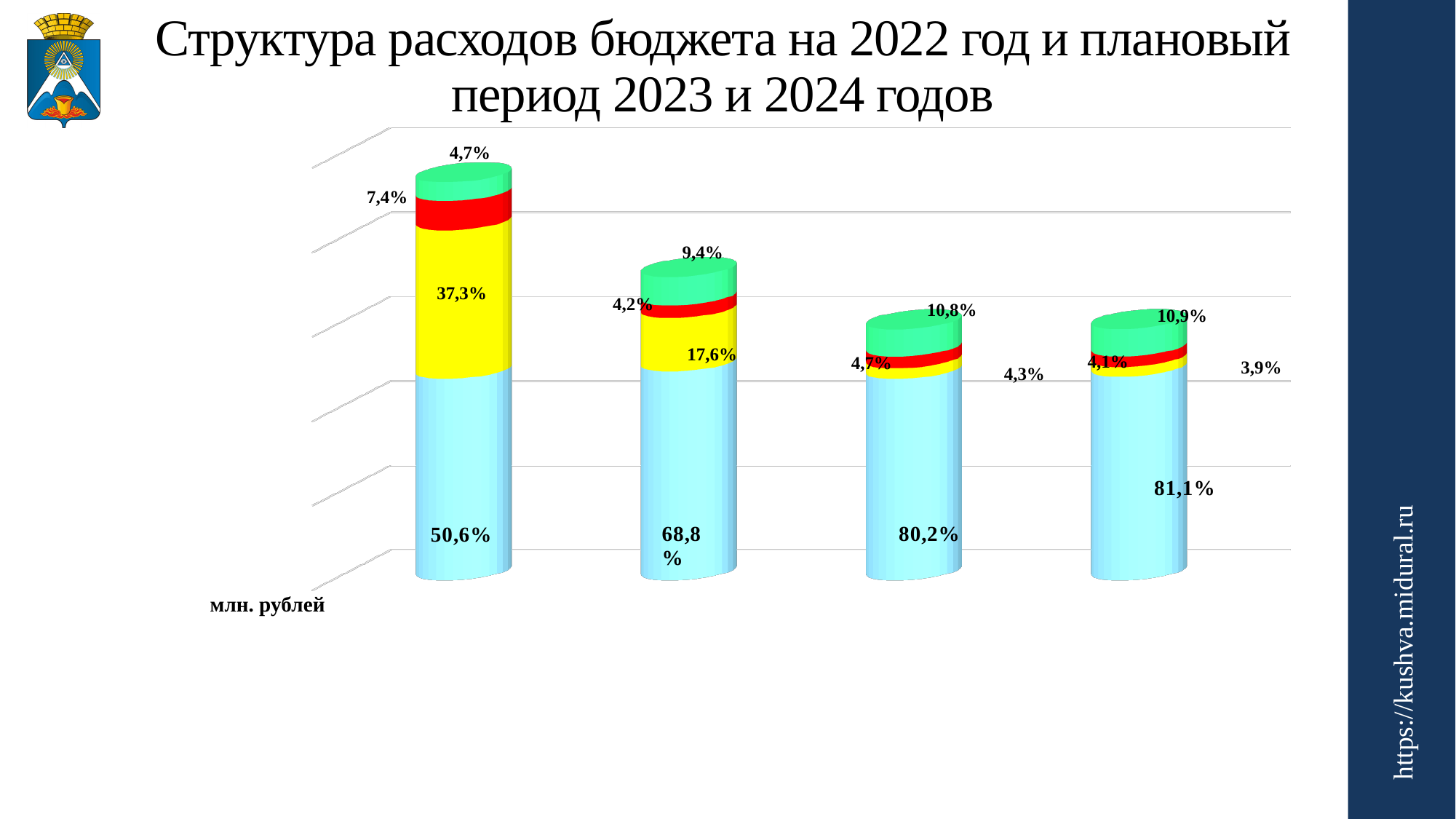
What is the value of the light blue segment of the first (leftmost) bar? 50,6% Do the light blue segment values rise or fall from the leftmost bar to the rightmost bar? rise Which bar has the largest light blue segment? the fourth (rightmost) bar, 81,1% What is the value of the green segment at the top of the fourth (rightmost) bar? 10,9% What is the difference between the yellow segment of the first bar (37,3%) and the yellow segment of the second bar (17,6%)? 19,7% What is the value of the yellow segment of the second bar from the left? 17,6% Which bar has the smallest light blue segment? the first (leftmost) bar, 50,6% Which is larger: the green segment of the first bar or the green segment of the second bar? the second bar (9,4%) What is the title of the slide containing the chart? Структура расходов бюджета на 2022 год и плановый период 2023 и 2024 годов What kind of chart is shown on the slide? stacked bar chart How many stacked bars are plotted in the chart? 4 What is the value of the red segment of the first (leftmost) bar? 7,4%